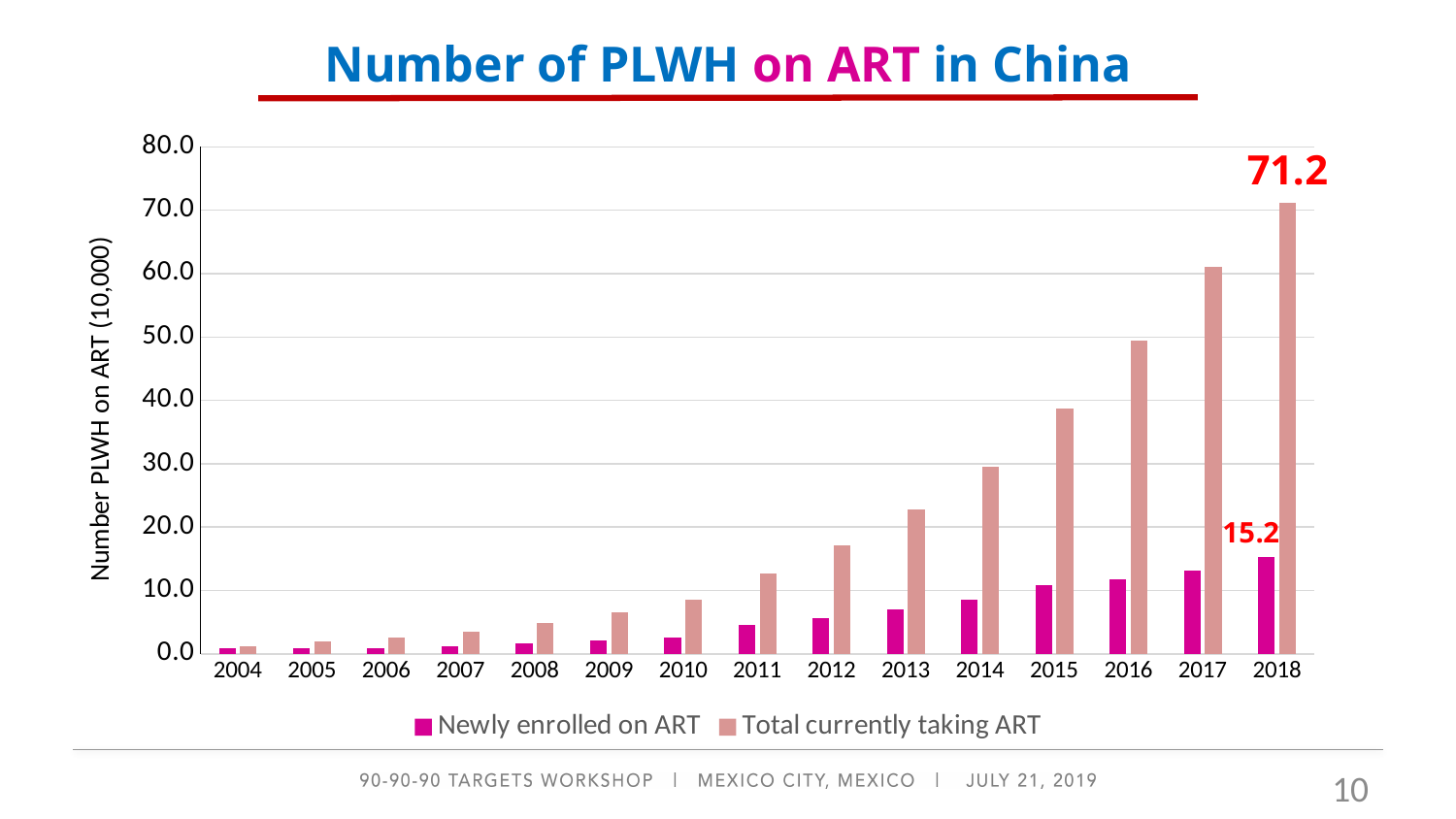
Is the value for Total currently taking ART in 2014 greater or less than 40.0? less What is the difference between Total currently taking ART and Newly enrolled on ART in 2018? 56.0 In 2018, which is larger: Newly enrolled on ART or Total currently taking ART? Total currently taking ART How many years are shown on the x axis? 15 What is the value for Newly enrolled on ART in 2018? 15.2 Which year has the highest value for Total currently taking ART? 2018 What is the value for Total currently taking ART in 2018? 71.2 Is the value for Total currently taking ART in 2017 greater or less than 50.0? greater Do the values for Total currently taking ART rise or fall from 2004 to 2018? Rise What kind of chart is shown on the slide? Bar chart How many series does the legend list? 2 Which year has the lowest value for Total currently taking ART? 2004